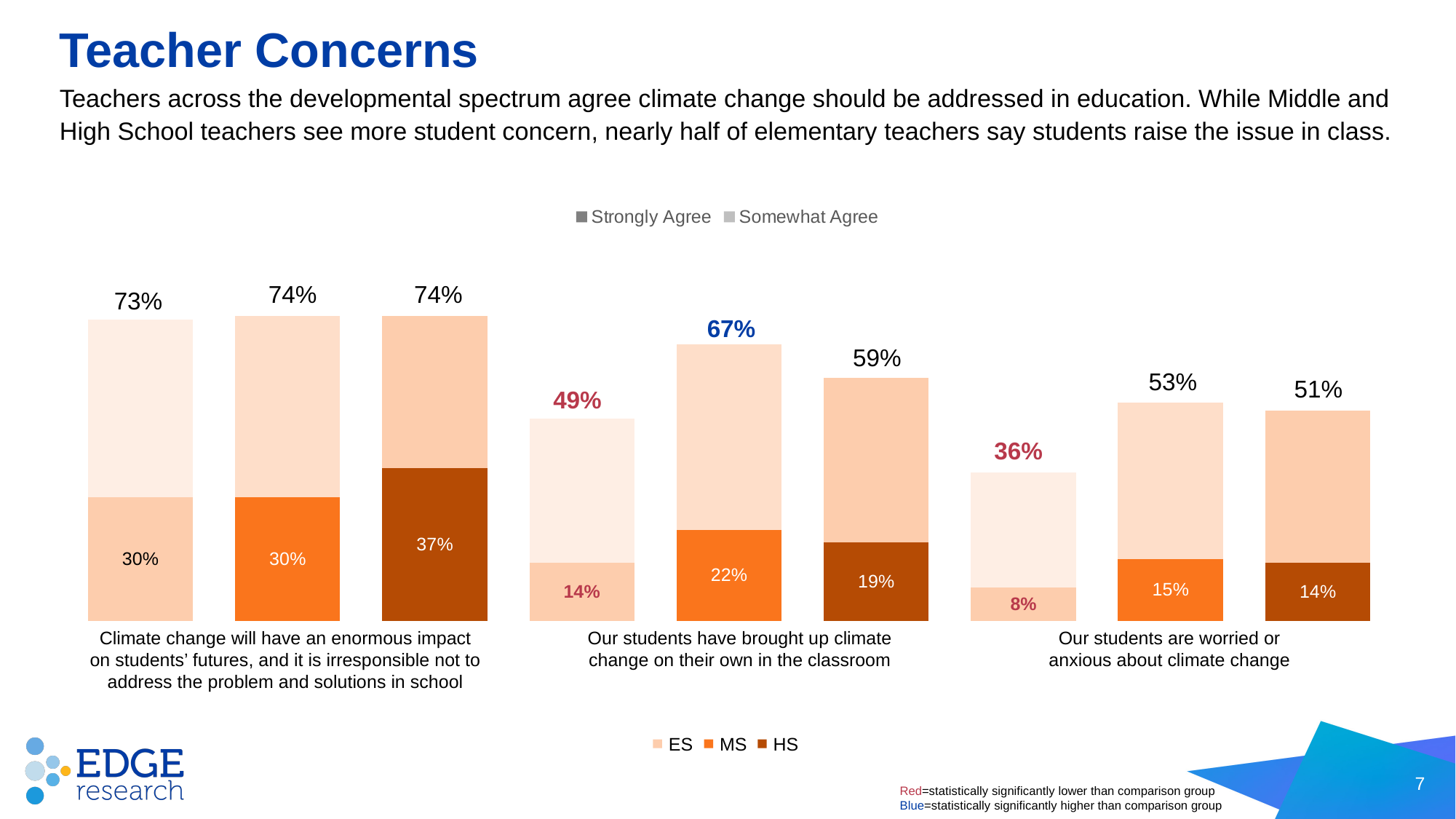
Which group (ES, MS or HS) has the lowest total agreement for "Our students are worried or anxious about climate change"? ES Which group (ES, MS or HS) has the highest total agreement for "Our students have brought up climate change on their own in the classroom"? MS What is the difference between the Strongly Agree values for MS and ES teachers on "Our students are worried or anxious about climate change"? 7% What type of chart is shown on the slide? Stacked bar chart Which is larger: the Strongly Agree share for HS teachers or for MS teachers on "Climate change will have an enormous impact on students' futures..."? HS What percentage of ES teachers strongly agree that "Our students are worried or anxious about climate change"? 8% What is the difference in total agreement between MS and ES teachers for "Our students have brought up climate change on their own in the classroom"? 18% How many statements (category groups) are shown on the x axis of the chart? 3 What is the total agreement (Strongly + Somewhat Agree) for HS teachers on "Our students have brought up climate change on their own in the classroom"? 59% Which total agreement values are shown in blue to indicate they are statistically significantly higher than the comparison group? 67% What is the Strongly Agree value for MS teachers on "Our students have brought up climate change on their own in the classroom"? 22% How many groups does the bottom legend list (ES, MS, HS)? 3